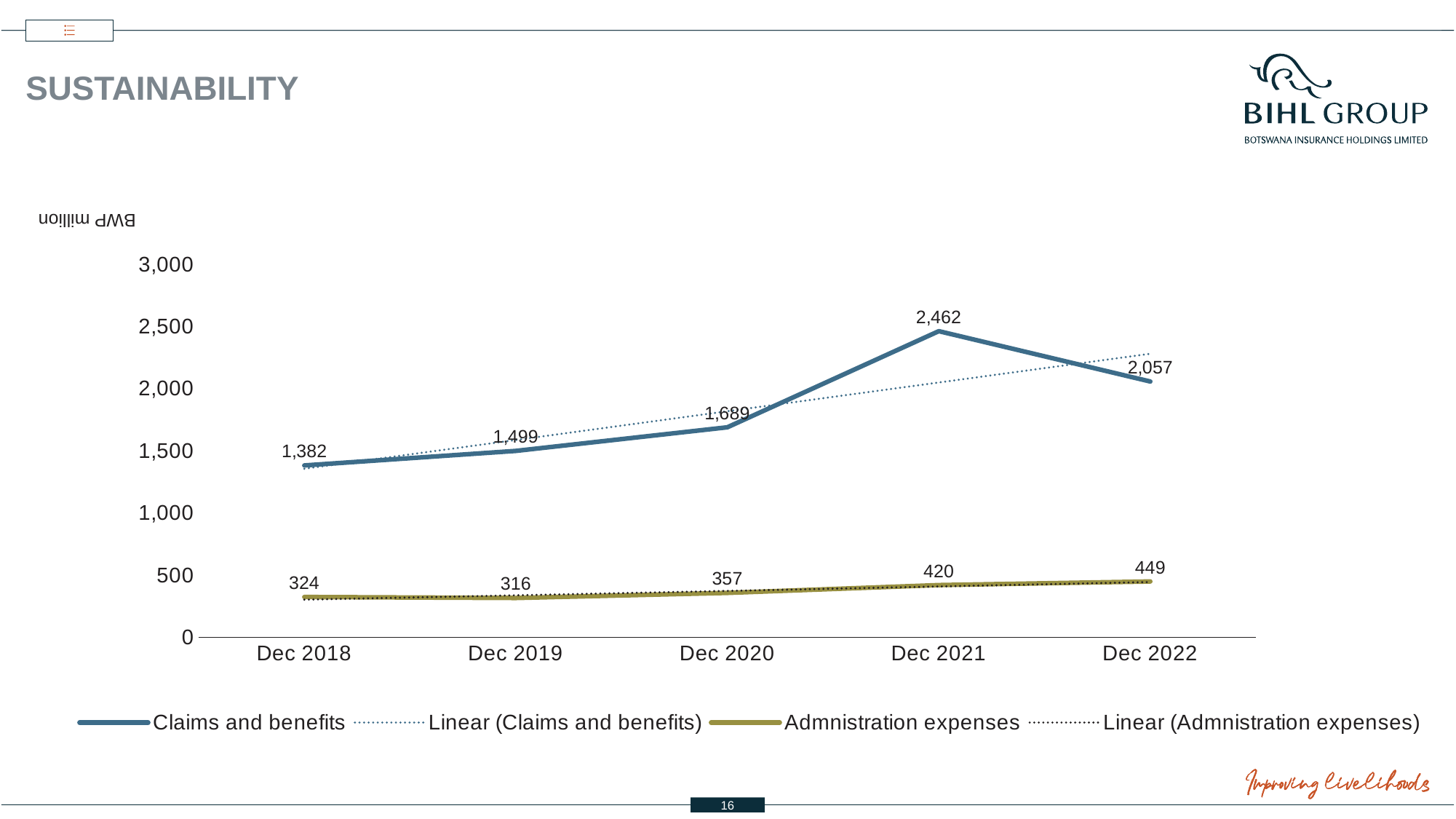
What is the difference between Claims and benefits in Dec 2021 and Dec 2022? 405 What unit is shown on the vertical axis label? BWP million How many entries does the legend list? 4 What is the value for Claims and benefits in Dec 2021? 2,462 Which is larger: Claims and benefits in Dec 2020 or in Dec 2019? Dec 2020 What is the difference between Admnistration expenses in Dec 2022 and Dec 2018? 125 In which period is Admnistration expenses lowest? Dec 2019 What kind of chart is shown on the slide? Line chart How many periods are shown on the x axis? 5 What is the value for Admnistration expenses in Dec 2019? 316 What is the value for Claims and benefits in Dec 2018? 1,382 In which period is Claims and benefits highest? Dec 2021